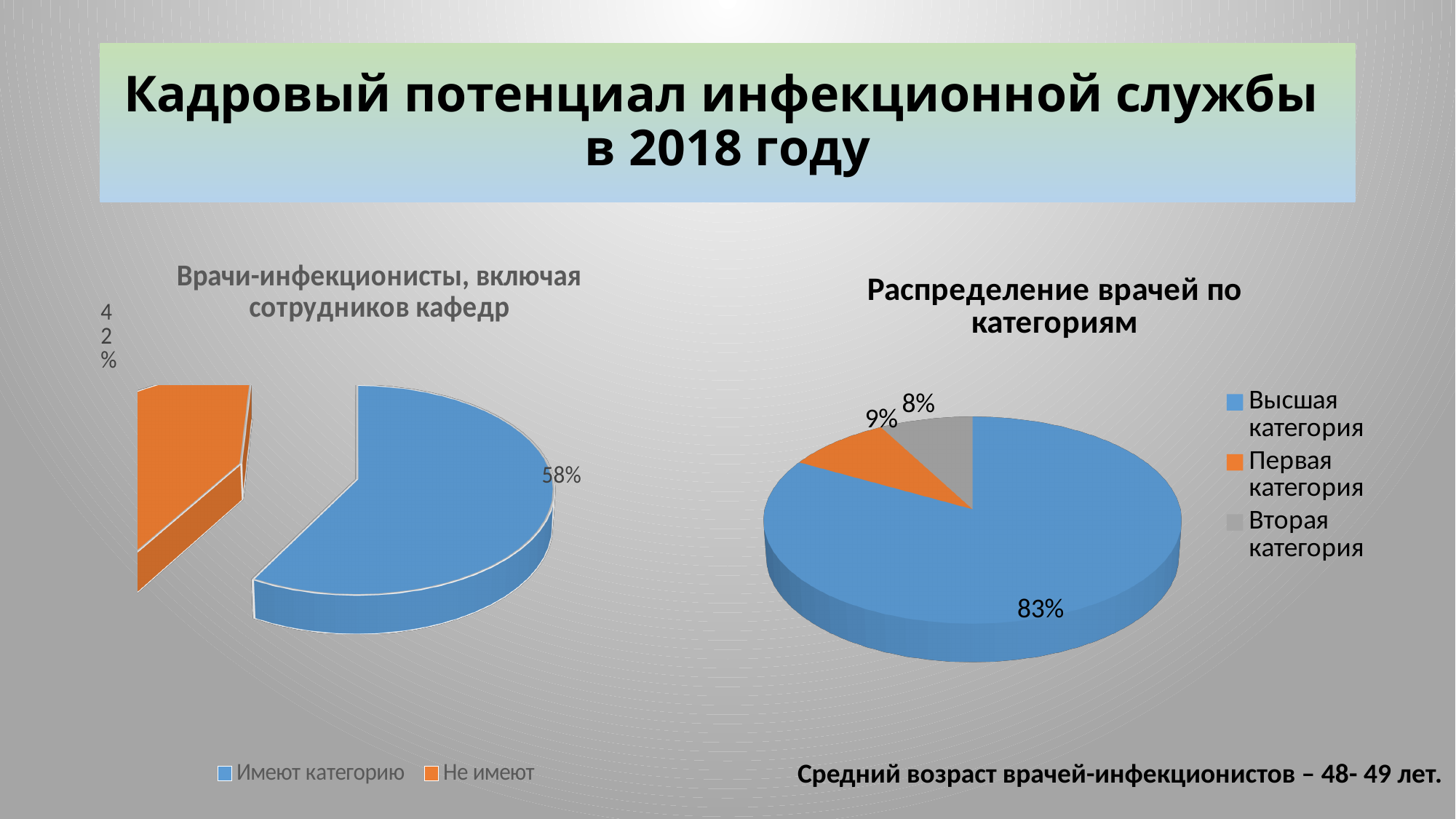
In the right chart "Распределение врачей по категориям", which category has the largest slice? Высшая категория In the right chart "Распределение врачей по категориям", what share is labelled for "Высшая категория"? 83% In the left chart "Врачи-инфекционисты, включая сотрудников кафедр", which slice is larger: "Имеют категорию" or "Не имеют"? Имеют категорию How many slices does the right chart "Распределение врачей по категориям" have? 3 In the left chart "Врачи-инфекционисты, включая сотрудников кафедр", what share is labelled for "Не имеют"? 42% In the left chart "Врачи-инфекционисты, включая сотрудников кафедр", what is the difference in percentage points between "Имеют категорию" and "Не имеют"? 16 In the left chart "Врачи-инфекционисты, включая сотрудников кафедр", what share is labelled for "Имеют категорию"? 58% In the right chart "Распределение врачей по категориям", what share is labelled for "Вторая категория"? 8% In the right chart "Распределение врачей по категориям", what share is labelled for "Первая категория"? 9% How many entries does the legend of the left chart "Врачи-инфекционисты, включая сотрудников кафедр" list? 2 What kind of chart is the left chart titled "Врачи-инфекционисты, включая сотрудников кафедр"? pie chart In the right chart "Распределение врачей по категориям", what colour is the slice for "Вторая категория"? grey